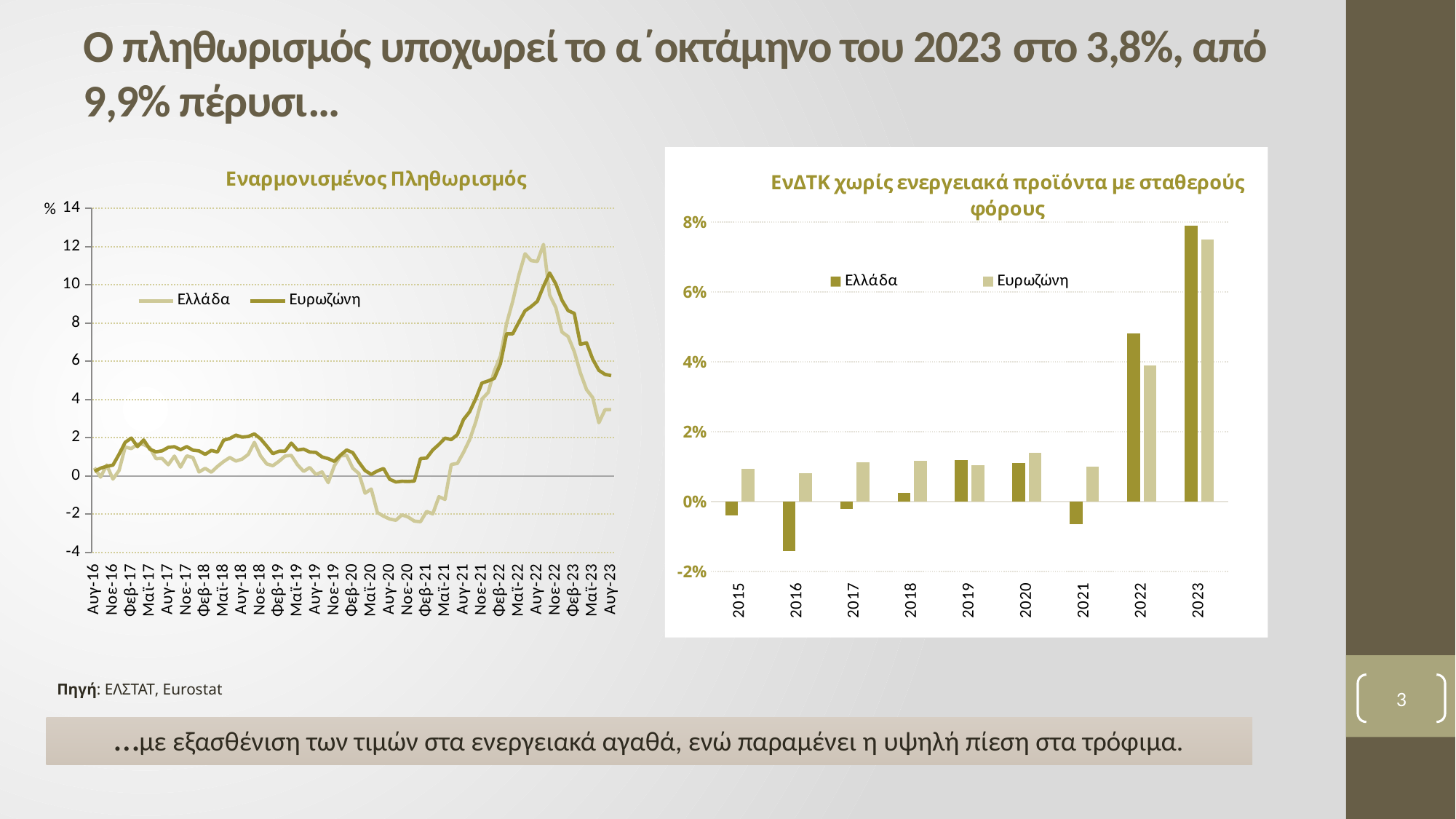
In the left chart 'Εναρμονισμένος Πληθωρισμός', which series reaches the higher peak in 2022: Ελλάδα or Ευρωζώνη? Ελλάδα In the right chart 'ΕνΔΤΚ χωρίς ενεργειακά προϊόντα με σταθερούς φόρους', is the value for Ελλάδα in 2022 greater or less than 4%? greater In the right chart 'ΕνΔΤΚ χωρίς ενεργειακά προϊόντα με σταθερούς φόρους', which year has the lowest value for Ελλάδα? 2016 What kind of chart is the right chart titled 'ΕνΔΤΚ χωρίς ενεργειακά προϊόντα με σταθερούς φόρους'? bar chart In the right chart 'ΕνΔΤΚ χωρίς ενεργειακά προϊόντα με σταθερούς φόρους', which year has the highest value for Ελλάδα? 2023 In the right chart 'ΕνΔΤΚ χωρίς ενεργειακά προϊόντα με σταθερούς φόρους', which is larger in 2021: Ελλάδα or Ευρωζώνη? Ευρωζώνη In the left chart 'Εναρμονισμένος Πληθωρισμός', do the values rise or fall from Αυγ-22 to Αυγ-23? fall How many years are shown on the x axis of the right chart 'ΕνΔΤΚ χωρίς ενεργειακά προϊόντα με σταθερούς φόρους'? 9 In the right chart 'ΕνΔΤΚ χωρίς ενεργειακά προϊόντα με σταθερούς φόρους', is the value for Ευρωζώνη in 2023 greater or less than 6%? greater How many series does the legend of the left chart 'Εναρμονισμένος Πληθωρισμός' list? 2 In the left chart 'Εναρμονισμένος Πληθωρισμός', is the peak value of the Ελλάδα line greater or less than 10? greater What kind of chart is the left chart titled 'Εναρμονισμένος Πληθωρισμός'? line chart